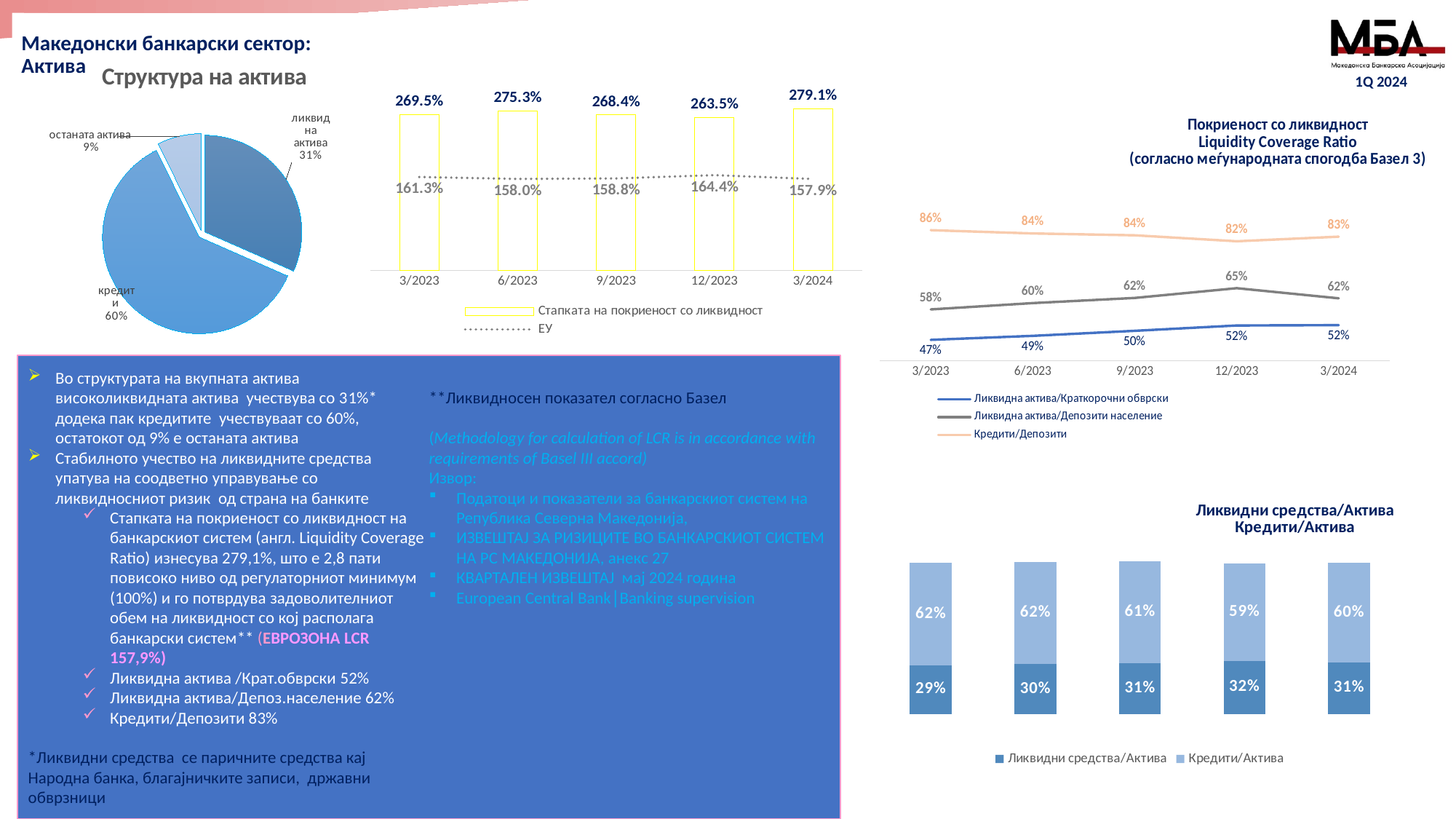
In the pie chart 'Структура на актива', which category has the smallest share? останата актива What type of chart is 'Ликвидни средства/Актива Кредити/Актива'? stacked bar chart In the line chart 'Покриеност со ликвидност Liquidity Coverage Ratio', does the 'Ликвидна актива/Краткорочни обврски' series rise or fall from 3/2023 to 3/2024? rise In the bar chart with the legend 'Стапката на покриеност со ликвидност', what is the difference between the liquidity coverage ratio and the EU value for 3/2024? 121.2% In the bar chart with the legend 'Стапката на покриеност со ликвидност', what is the value for 3/2024? 279.1% In the bar chart with the legend 'Стапката на покриеност со ликвидност', which period has the lowest value for the liquidity coverage ratio bars? 12/2023 In the bar chart with the legend 'Стапката на покриеност со ликвидност', what is the EU (ЕУ) value for 12/2023? 164.4% How many slices does the pie chart 'Структура на актива' have? 3 In the line chart 'Покриеност со ликвидност Liquidity Coverage Ratio', what is the value of 'Кредити/Депозити' for 3/2023? 86% In the pie chart 'Структура на актива', what share of assets is 'кредити'? 60% In the stacked bar chart 'Ликвидни средства/Актива Кредити/Актива', what is the value of 'Ликвидни средства/Актива' for the fourth bar? 32% In the line chart 'Покриеност со ликвидност Liquidity Coverage Ratio', how many series does the legend list? 3